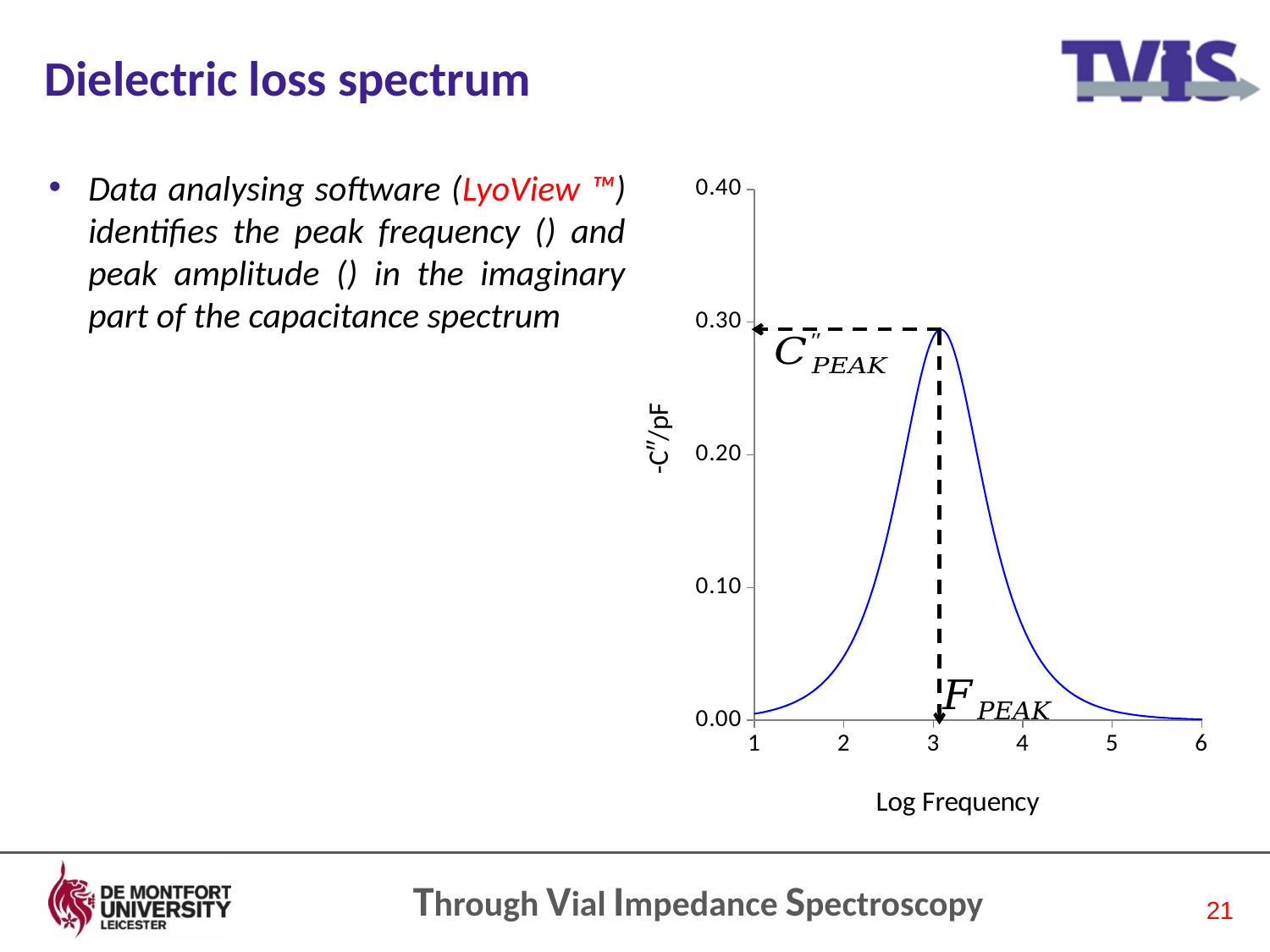
Is the value of the curve at log frequency 1 greater or less than 0.10? less Is the value of the curve at log frequency 4 greater or less than 0.20? less Is the peak value of the curve greater or less than 0.20? greater How many curves are plotted on the chart? 1 What is the label of the y axis of the chart? -C''/pF What kind of chart is shown on the slide? line chart What is the label of the x axis of the chart? Log Frequency Does the curve rise or fall as log frequency increases from 3 to 6? fall Which is larger, the value of the curve at log frequency 3 or at log frequency 5? log frequency 3 Does the curve rise or fall as log frequency increases from 1 to 3? rise